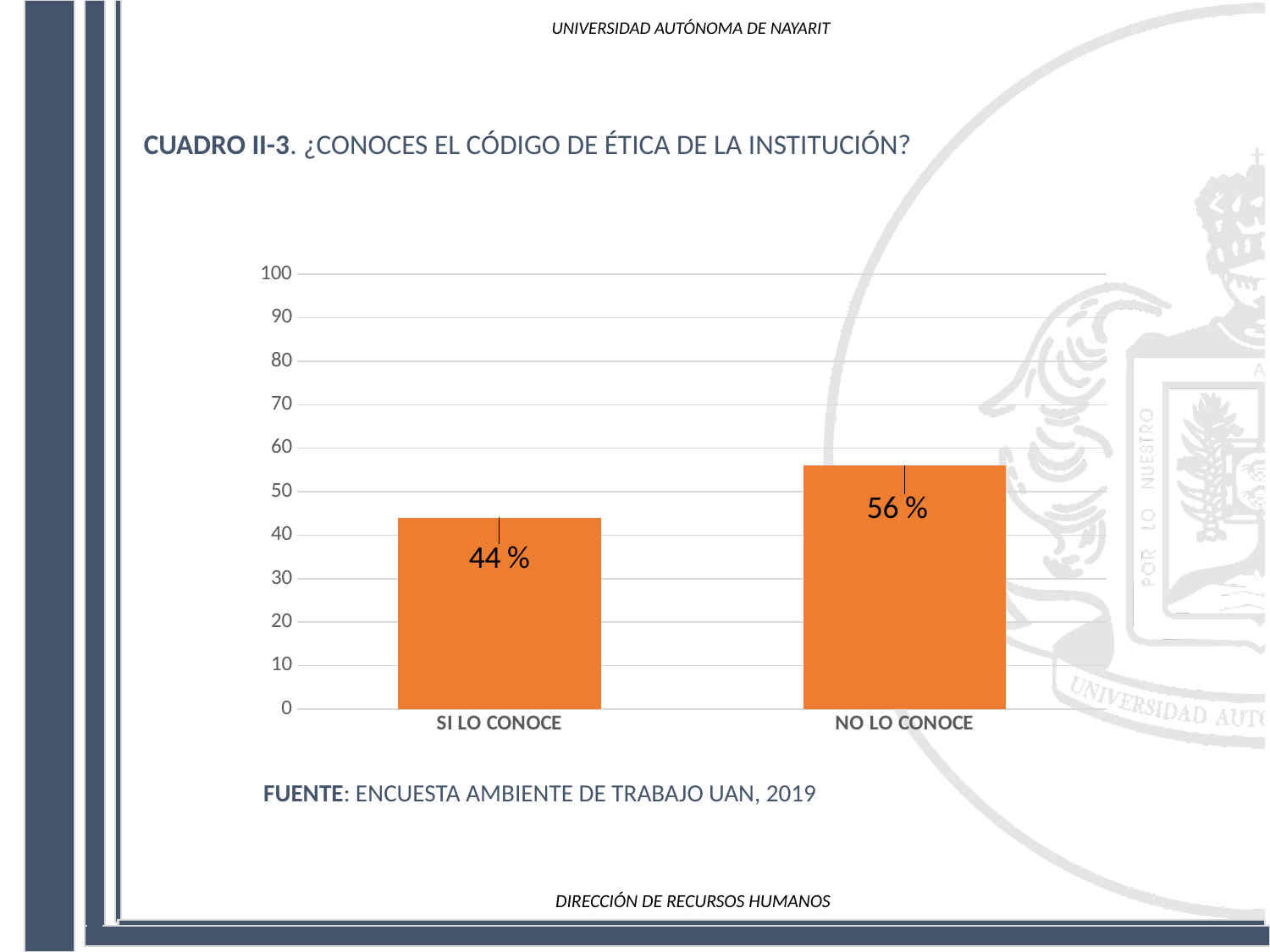
Is the value for NO LO CONOCE greater or less than 50? greater What is the value for SI LO CONOCE? 44 % What kind of chart is shown on the slide? bar chart What is the title of the chart on the slide? CUADRO II-3. ¿CONOCES EL CÓDIGO DE ÉTICA DE LA INSTITUCIÓN? Is the value for SI LO CONOCE greater or less than 50? less Which is larger, the value for SI LO CONOCE or the value for NO LO CONOCE? NO LO CONOCE How many categories are shown on the x axis? 2 What source is cited below the chart? ENCUESTA AMBIENTE DE TRABAJO UAN, 2019 Which category has the highest value? NO LO CONOCE What is the value for NO LO CONOCE? 56 % Which category has the lowest value? SI LO CONOCE What is the difference between the values for NO LO CONOCE and SI LO CONOCE? 12 %